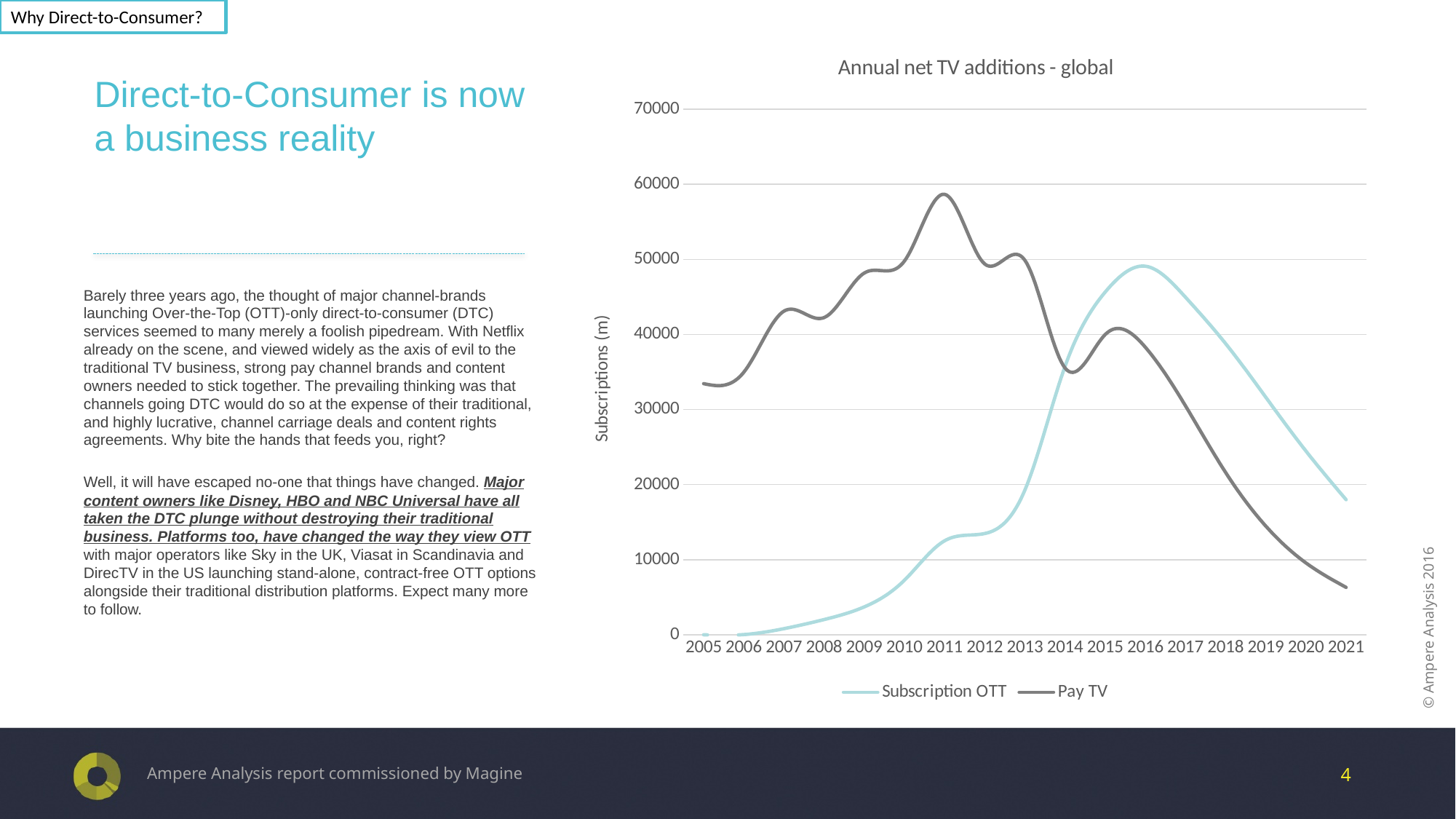
In which year does the Pay TV series reach its highest value? 2011 Does the Subscription OTT series rise or fall between 2016 and 2021? fall How many series does the legend of the chart list? 2 In which year does the Subscription OTT series reach its highest value? 2016 Is the Pay TV value for 2011 greater or less than 50000? greater In 2021, which series has the larger value, Subscription OTT or Pay TV? Subscription OTT What is the title of the chart? Annual net TV additions - global Is the Subscription OTT value for 2021 greater or less than 20000? less In 2009, which series has the larger value, Subscription OTT or Pay TV? Pay TV How many years are shown on the x axis of the chart? 17 In which year is the Pay TV series at its lowest value? 2021 What kind of chart is shown on the slide? line chart